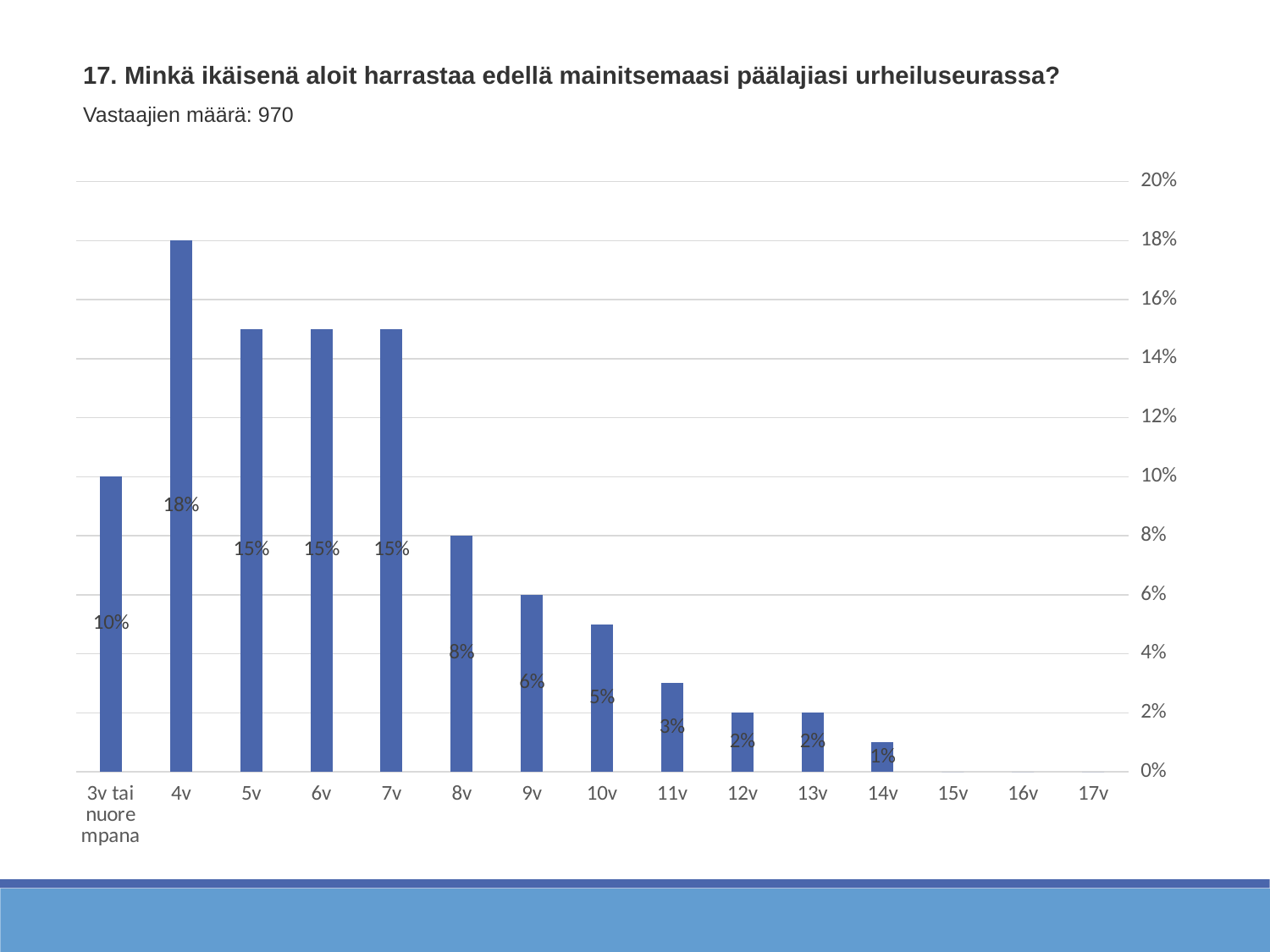
What kind of chart is shown on the slide? bar chart What is the difference between the values for 4v and 9v? 12% What is the value for 3v tai nuorempana? 10% What is the number of respondents (Vastaajien määrä) stated on the slide? 970 Do the values rise or fall along the x axis from 4v to 14v? fall What is the value for 4v? 18% What is the value for 8v? 8% What is the value for 14v? 1% Which is larger, the value for 10v or the value for 11v? 10v Is the value for 5v greater or less than 14%? greater Which category has the highest value? 4v How many categories are shown on the x axis? 15